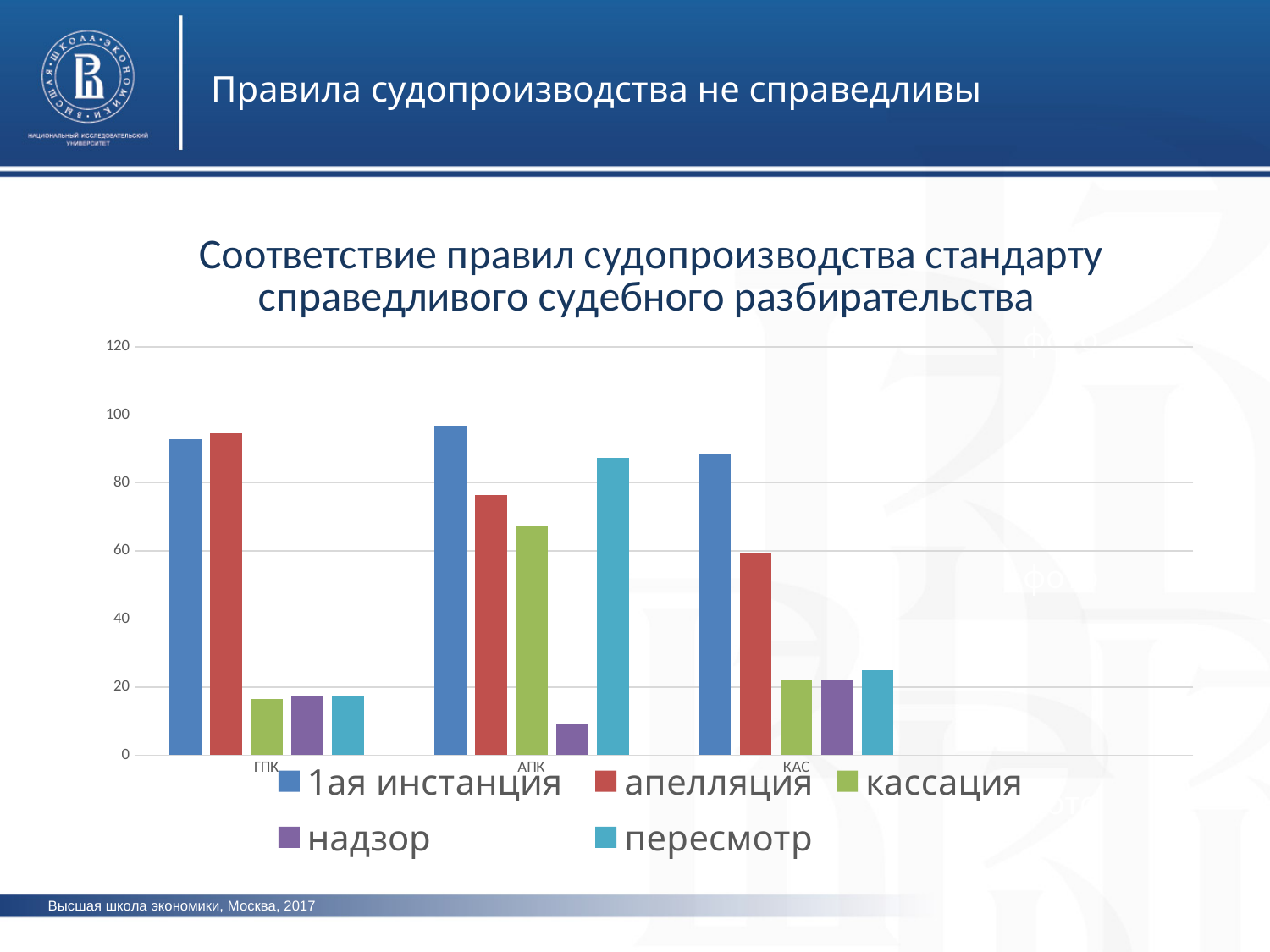
Is the value for апелляция in the КАС category greater or less than 40? greater What is the title of the chart? Соответствие правил судопроизводства стандарту справедливого судебного разбирательства Is the value for надзор in the АПК category greater or less than 20? less How many categories are shown on the x axis of the chart? 3 Which series has the lowest value in the АПК category? надзор Which category has the highest value for кассация? АПК Which series is shown in red in the chart? апелляция Is the value for кассация in the ГПК category greater or less than 20? less Which is larger in the АПК category: пересмотр or апелляция? пересмотр What kind of chart is shown on the slide? bar chart How many series does the chart legend list? 5